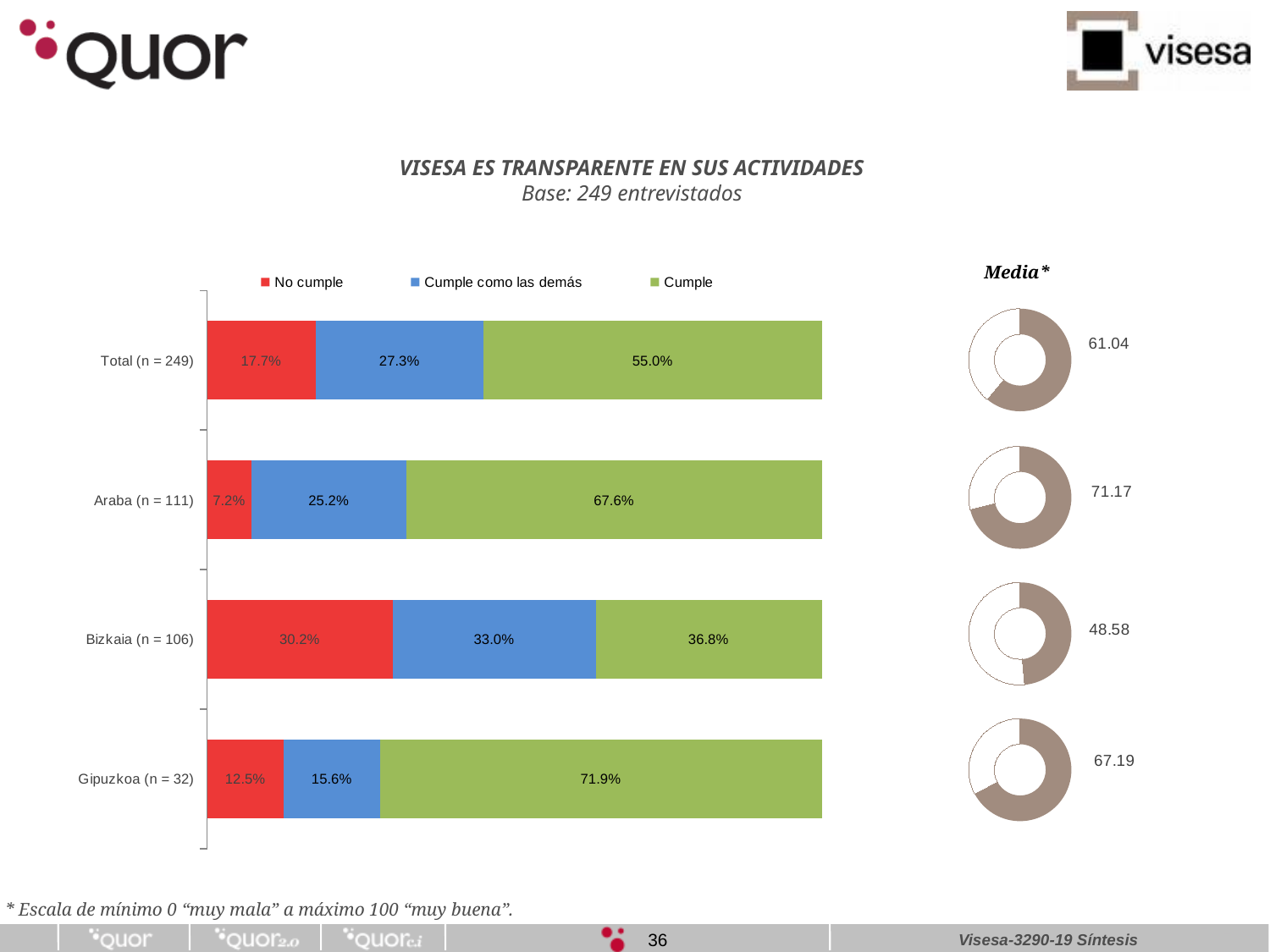
What kind of chart is the main chart on the left of the slide? Stacked bar chart How many series does the legend of the stacked bar chart list? 3 In the Media* donut charts, what is the value shown for Bizkaia (n = 106)? 48.58 In the stacked bar chart, which category has the lowest 'No cumple' value? Araba (n = 111) In the stacked bar chart, which category has the highest 'Cumple' value? Gipuzkoa (n = 32) How many categories are shown in the stacked bar chart? 4 In the stacked bar chart, what is the 'No cumple' value for Bizkaia (n = 106)? 30.2% In the Media* donut charts, which category has the highest value? Araba (n = 111) In the stacked bar chart, which is larger: the 'Cumple como las demás' value for Total (n = 249) or for Araba (n = 111)? Total (n = 249) In the stacked bar chart, what is the difference between the 'Cumple' values for Gipuzkoa (n = 32) and Bizkaia (n = 106)? 35.1% In the stacked bar chart, what is the 'Cumple' value for Araba (n = 111)? 67.6% In the stacked bar chart, what is the 'Cumple como las demás' value for Gipuzkoa (n = 32)? 15.6%